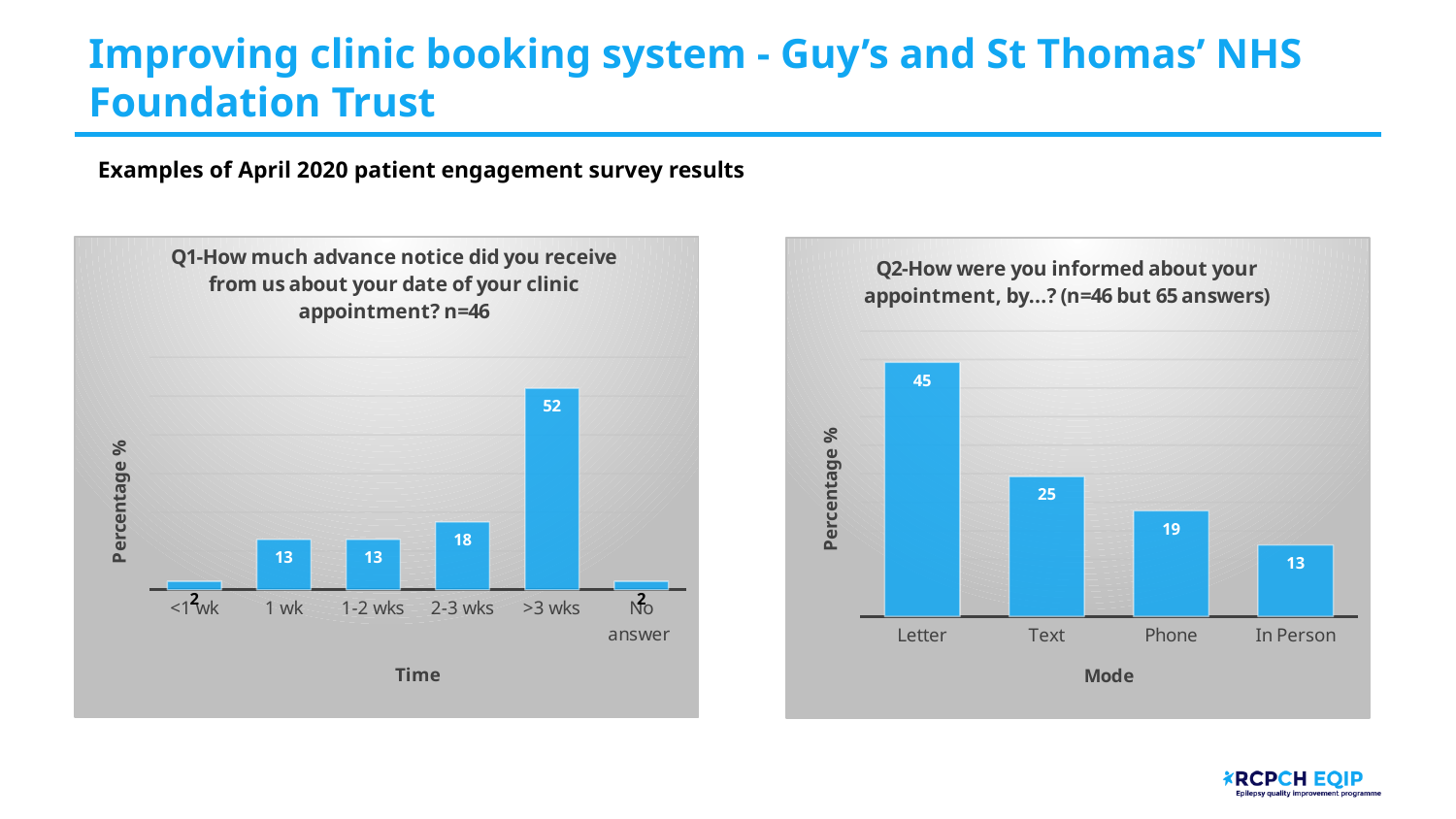
In the Q1 chart (left), what is the label of the x axis? Time In the Q2 chart (right), which category has the lowest value? In Person In the Q2 chart (right), which is larger, the value for 'Phone' or the value for 'In Person'? Phone In the Q1 chart (left), what is the value for '2-3 wks'? 18 In the Q1 chart (left), how many categories are shown on the x axis? 6 In the Q2 chart (right), what is the value for 'Text'? 25 In the Q2 chart (right), do the values rise or fall from left to right along the x axis? fall In the Q2 chart (right), what is the difference between the values for 'Letter' and 'Text'? 20 In the Q1 chart (left), what is the difference between the values for '>3 wks' and '2-3 wks'? 34 In the Q1 chart (left), which category has the highest value? >3 wks In the Q1 chart (left), what is the value for '>3 wks'? 52 What kind of chart is the Q2 chart (right)? bar chart